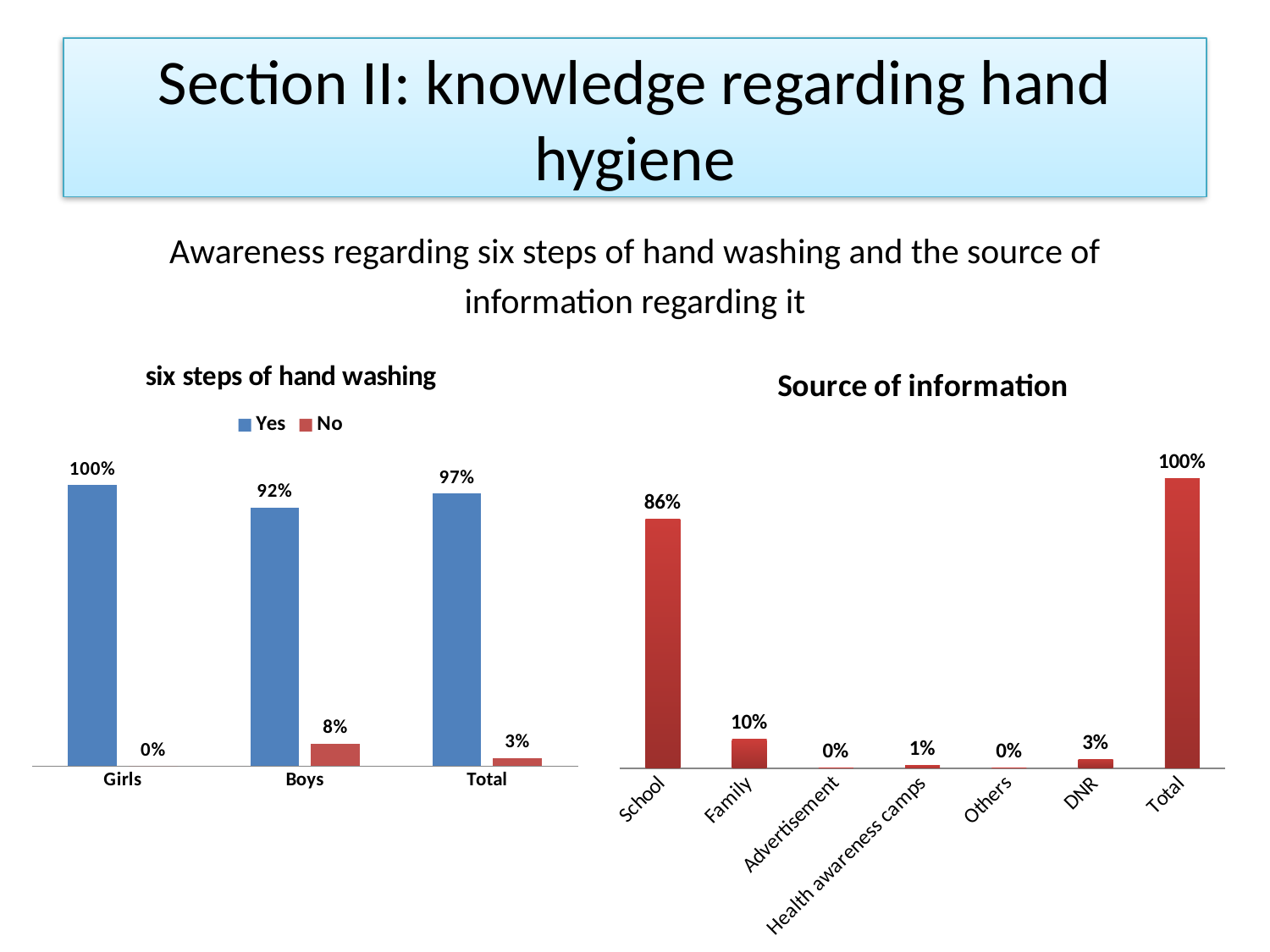
In the 'Source of information' chart, what is the value for DNR? 3% In the 'six steps of hand washing' chart, how many categories are shown on the x axis? 3 In the 'Source of information' chart, what is the difference between the values for School and Family? 76% In the 'six steps of hand washing' chart, which category has the highest Yes value? Girls In the 'Source of information' chart, which is larger, the value for Family or the value for DNR? Family In the 'Source of information' chart, which source (excluding Total) has the highest value? School In the 'six steps of hand washing' chart, what is the Yes value for Boys? 92% What kind of chart is the 'Source of information' chart? Bar chart In the 'Source of information' chart, what is the value for School? 86% In the 'six steps of hand washing' chart, what is the No value for Total? 3% In the 'six steps of hand washing' chart, how many series does the legend list? 2 In the 'six steps of hand washing' chart, what is the difference between the Yes values for Girls and Boys? 8%